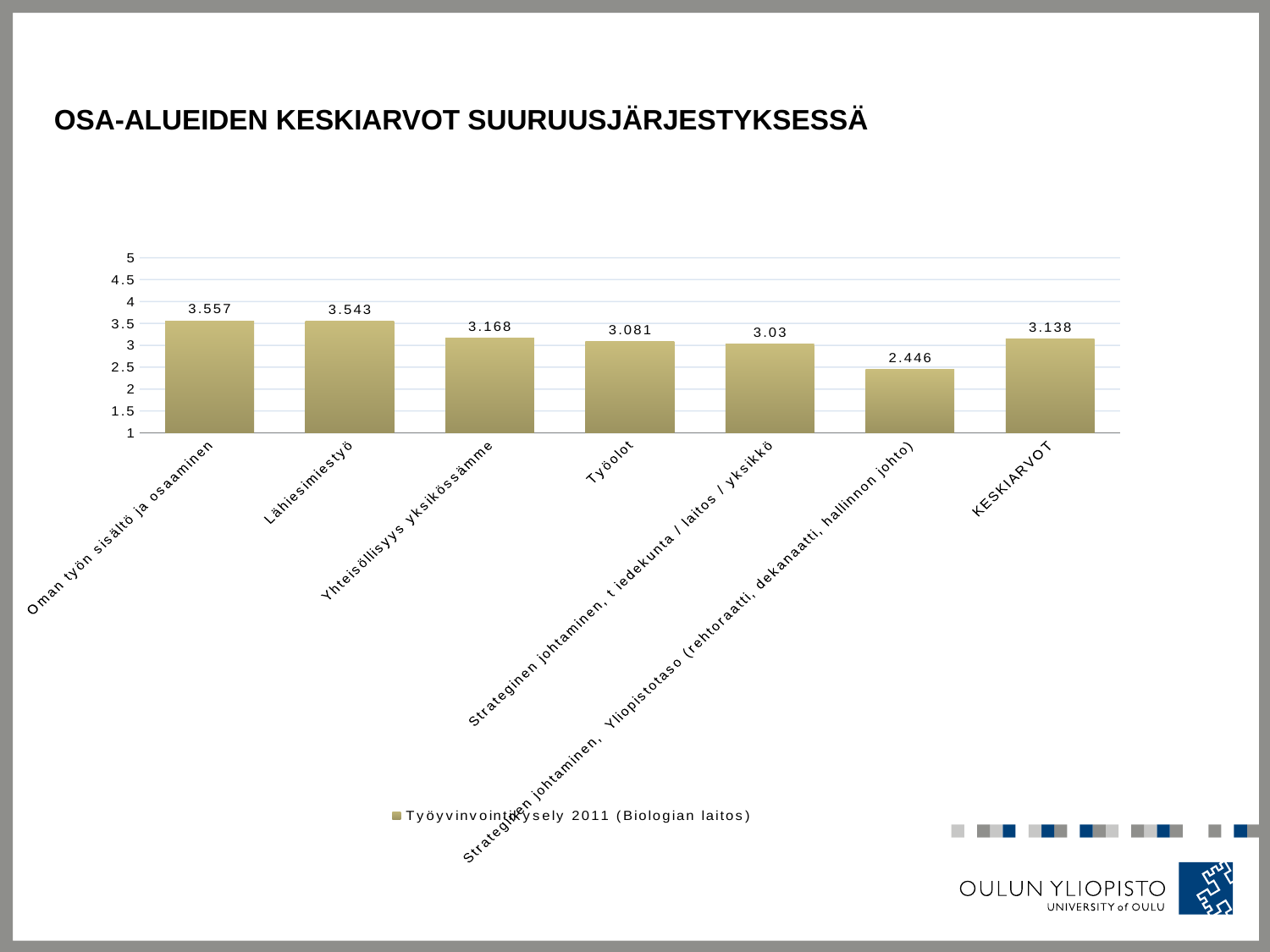
What is the value for Työolot? 3.081 What is the title of the slide? OSA-ALUEIDEN KESKIARVOT SUURUUSJÄRJESTYKSESSÄ What is the value for Lähiesimiestyö? 3.543 Which is larger, the value for Yhteisöllisyys yksikössämme or the value for KESKIARVOT? Yhteisöllisyys yksikössämme What is the difference between the values for Oman työn sisältö ja osaaminen and Työolot? 0.476 What is the value for KESKIARVOT? 3.138 Which category has the lowest value? Strateginen johtaminen, Yliopistotaso (rehtoraatti, dekanaatti, hallinnon johto) Is the value for Strateginen johtaminen, Yliopistotaso (rehtoraatti, dekanaatti, hallinnon johto) greater or less than 3? less How many categories are shown on the x axis? 7 What is the value for Yhteisöllisyys yksikössämme? 3.168 Which category has the highest value? Oman työn sisältö ja osaaminen What kind of chart is shown on the slide? bar chart